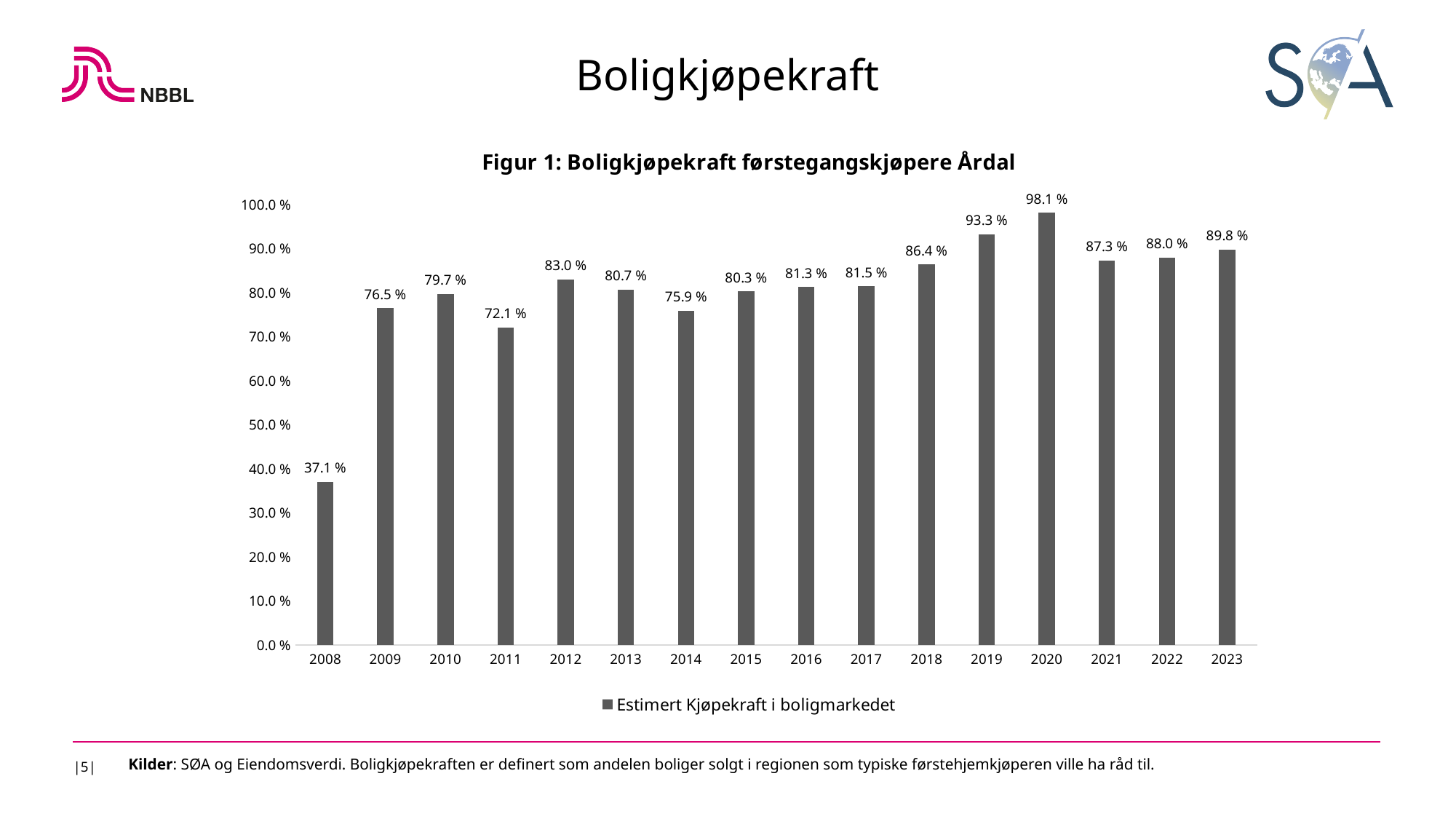
What is the difference between the values for 2020 and 2019? 4.8 % What kind of chart is shown? bar chart How many years are shown on the x axis? 16 What is the value for 2020? 98.1 % Is the value for 2018 greater or less than 80.0 %? greater How many series does the legend list? 1 Which is larger, the value for 2011 or the value for 2014? 2014 What is the value for 2023? 89.8 % Which year has the highest value? 2020 Which year has the lowest value? 2008 What is the value for 2008? 37.1 % What is the legend entry for the series? Estimert Kjøpekraft i boligmarkedet